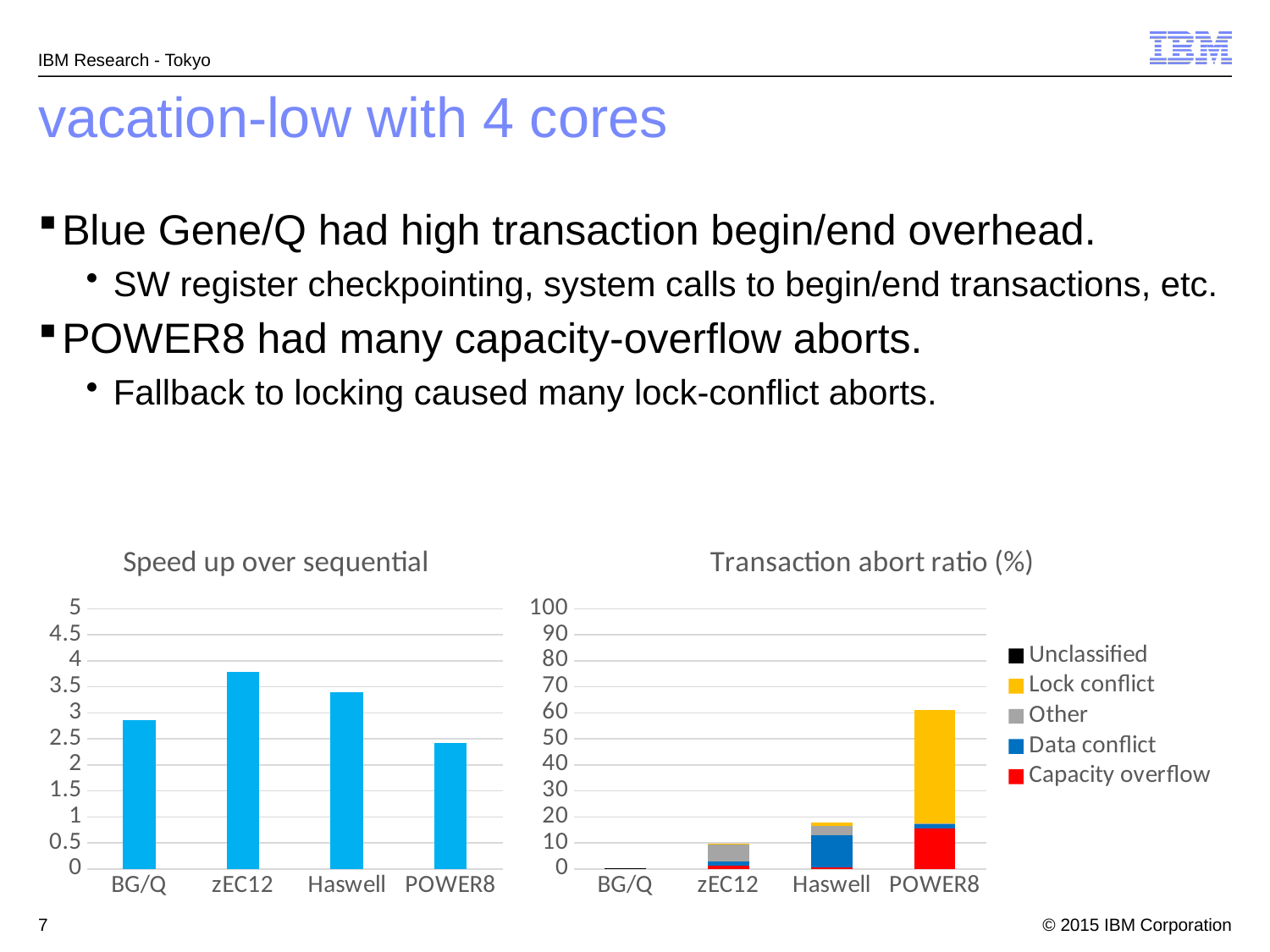
In the "Transaction abort ratio (%)" chart, is the total for Haswell greater or less than 30? less In the "Transaction abort ratio (%)" chart, which category has the tallest stacked bar? POWER8 In the "Transaction abort ratio (%)" chart, which series is shown in yellow? Lock conflict How many series does the legend of the "Transaction abort ratio (%)" chart list? 5 In the "Speed up over sequential" chart, which category has the highest speed-up? zEC12 In the "Speed up over sequential" chart, which is larger, the value for Haswell or the value for BG/Q? Haswell What kind of chart is the "Speed up over sequential" chart? bar chart How many categories are shown on the x axis of the "Speed up over sequential" chart? 4 In the "Speed up over sequential" chart, is the value for POWER8 greater or less than 3? less In the "Speed up over sequential" chart, is the value for zEC12 greater or less than 3.5? greater In the "Speed up over sequential" chart, which category has the lowest speed-up? POWER8